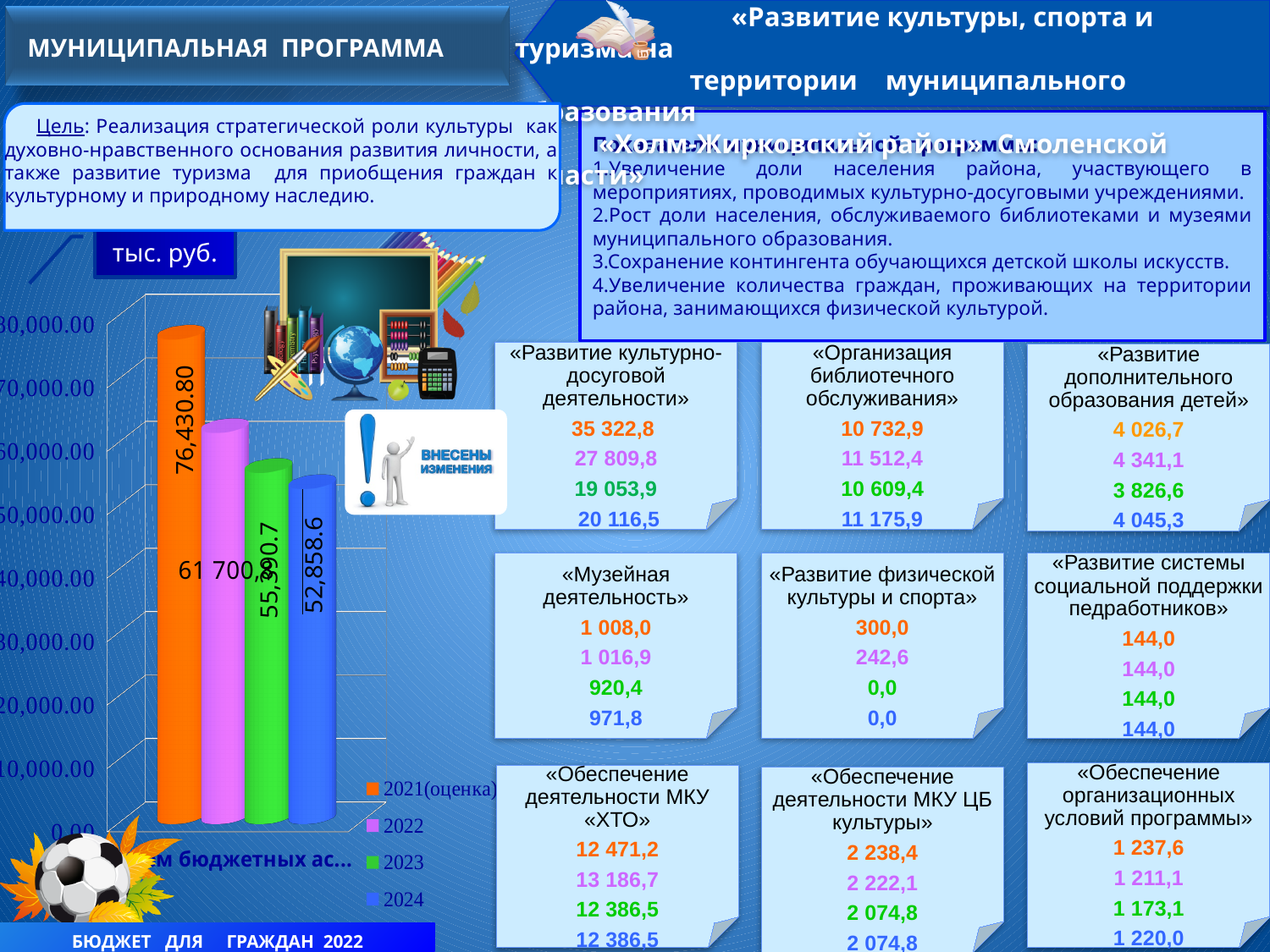
What is the value of the bar for 2024? 52,858.6 Which year has the highest bar in the chart? 2021(оценка) How many series does the chart legend list? 4 What type of chart is shown on the left of the slide? bar chart What is the value of the bar for 2023? 55,390.7 Which year has the lowest bar in the chart? 2024 What is the value of the bar for 2021(оценка)? 76,430.80 Is the value for 2022 greater or less than 70,000.00? less What is the difference between the 2021(оценка) value and the 2024 value? 23,572.2 Do the bar values rise or fall from 2021(оценка) to 2024? fall Which is larger, the bar for 2023 or the bar for 2024? 2023 What is the difference between the 2023 value and the 2024 value? 2,532.1